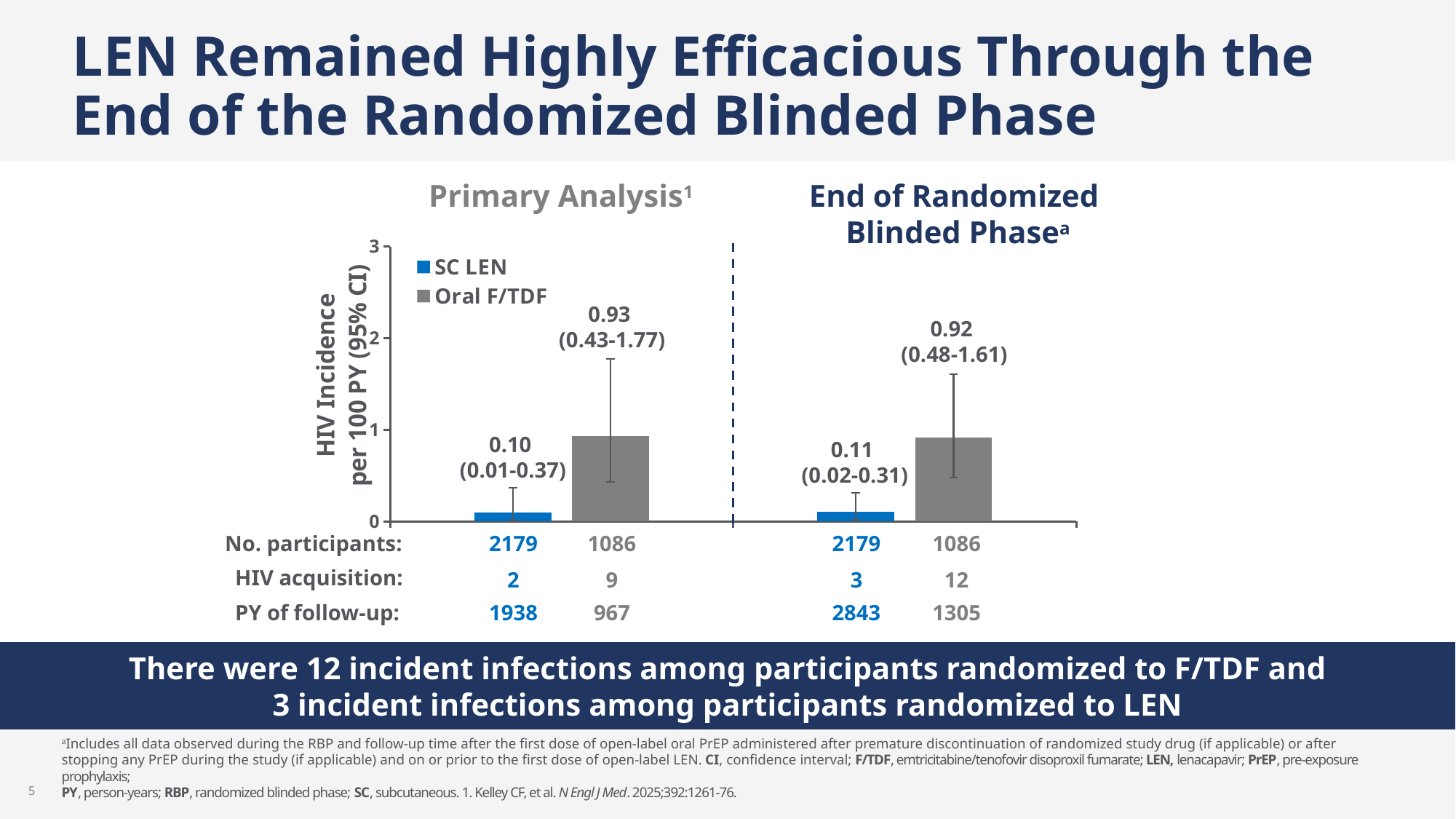
How many series does the legend list? 2 What is the HIV incidence per 100 PY for Oral F/TDF at the End of Randomized Blinded Phase? 0.92 What is the 95% CI for Oral F/TDF at the End of Randomized Blinded Phase? 0.48-1.61 Which group has the higher HIV incidence in the Primary Analysis, SC LEN or Oral F/TDF? Oral F/TDF What colour represents SC LEN in the chart? Blue How many HIV acquisitions were there in the Oral F/TDF group at the End of Randomized Blinded Phase? 12 What is the HIV incidence per 100 PY for SC LEN at the End of Randomized Blinded Phase? 0.11 What kind of chart is shown on the slide? Bar chart What is the difference in HIV incidence per 100 PY between Oral F/TDF and SC LEN at the End of Randomized Blinded Phase? 0.81 Is the HIV incidence for Oral F/TDF in the Primary Analysis greater or less than 1? less What is the HIV incidence per 100 PY for Oral F/TDF in the Primary Analysis? 0.93 What is the HIV incidence per 100 PY for SC LEN in the Primary Analysis? 0.10